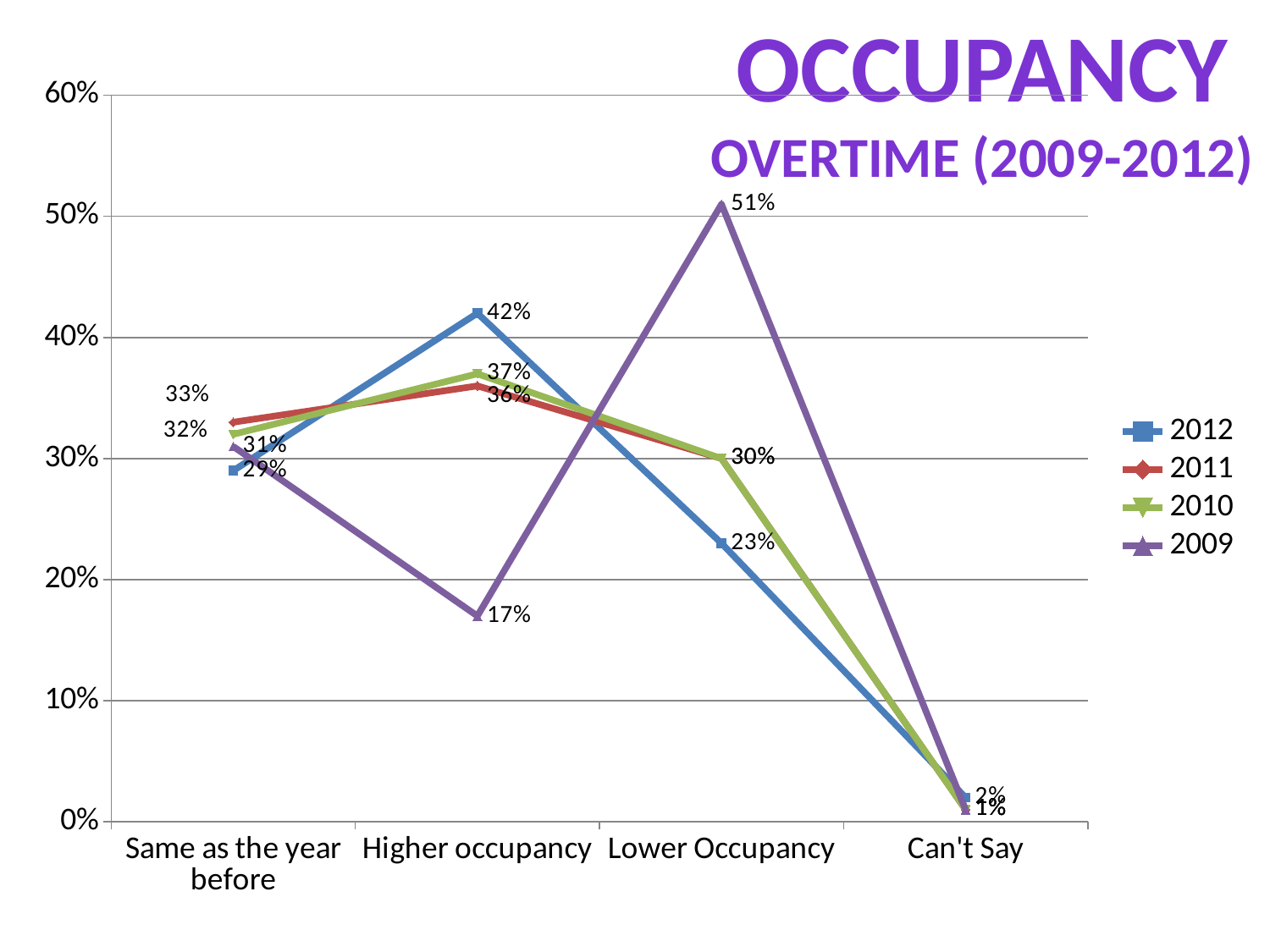
What is the value for 2012 at Lower Occupancy? 23% Which series has the highest value at Lower Occupancy? 2009 How many series does the legend list? 4 What is the value for 2009 at Lower Occupancy? 51% What is the value for 2009 at Higher occupancy? 17% Which series has the lowest value at Higher occupancy? 2009 What is the value for 2012 at Same as the year before? 29% How many categories are shown on the x axis? 4 At Higher occupancy, which is larger: the value for 2012 or the value for 2009? 2012 What is the value for 2012 at Higher occupancy? 42% What is the difference between the 2012 values for Higher occupancy and Lower Occupancy? 19 percentage points What kind of chart is shown on the slide? line chart